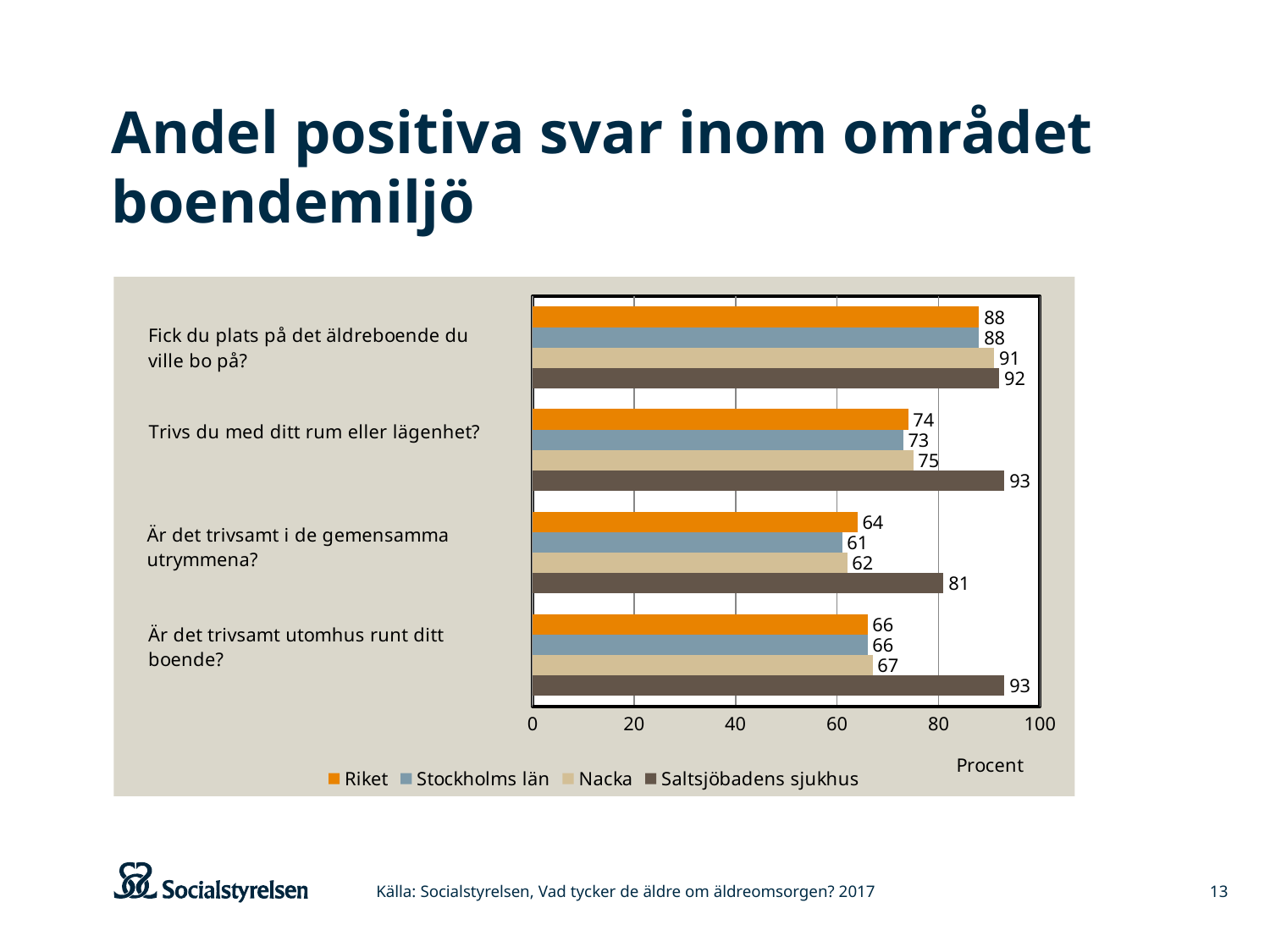
Which series has the lowest value for 'Är det trivsamt i de gemensamma utrymmena?' Stockholms län What is the value for Stockholms län for 'Är det trivsamt i de gemensamma utrymmena?' 61 Which series has the highest value for 'Trivs du med ditt rum eller lägenhet?' Saltsjöbadens sjukhus What is the value for Riket for 'Är det trivsamt utomhus runt ditt boende?' 66 Which is larger for 'Är det trivsamt i de gemensamma utrymmena?': Riket or Saltsjöbadens sjukhus? Saltsjöbadens sjukhus What kind of chart is shown on the slide? bar chart How many series does the legend list? 4 What is the value for Saltsjöbadens sjukhus for 'Trivs du med ditt rum eller lägenhet?' 93 What is the difference between Saltsjöbadens sjukhus and Riket for 'Är det trivsamt utomhus runt ditt boende?' 27 What is the value for Nacka for 'Fick du plats på det äldreboende du ville bo på?' 91 How many question categories are shown on the chart? 4 What is the label on the x axis? Procent